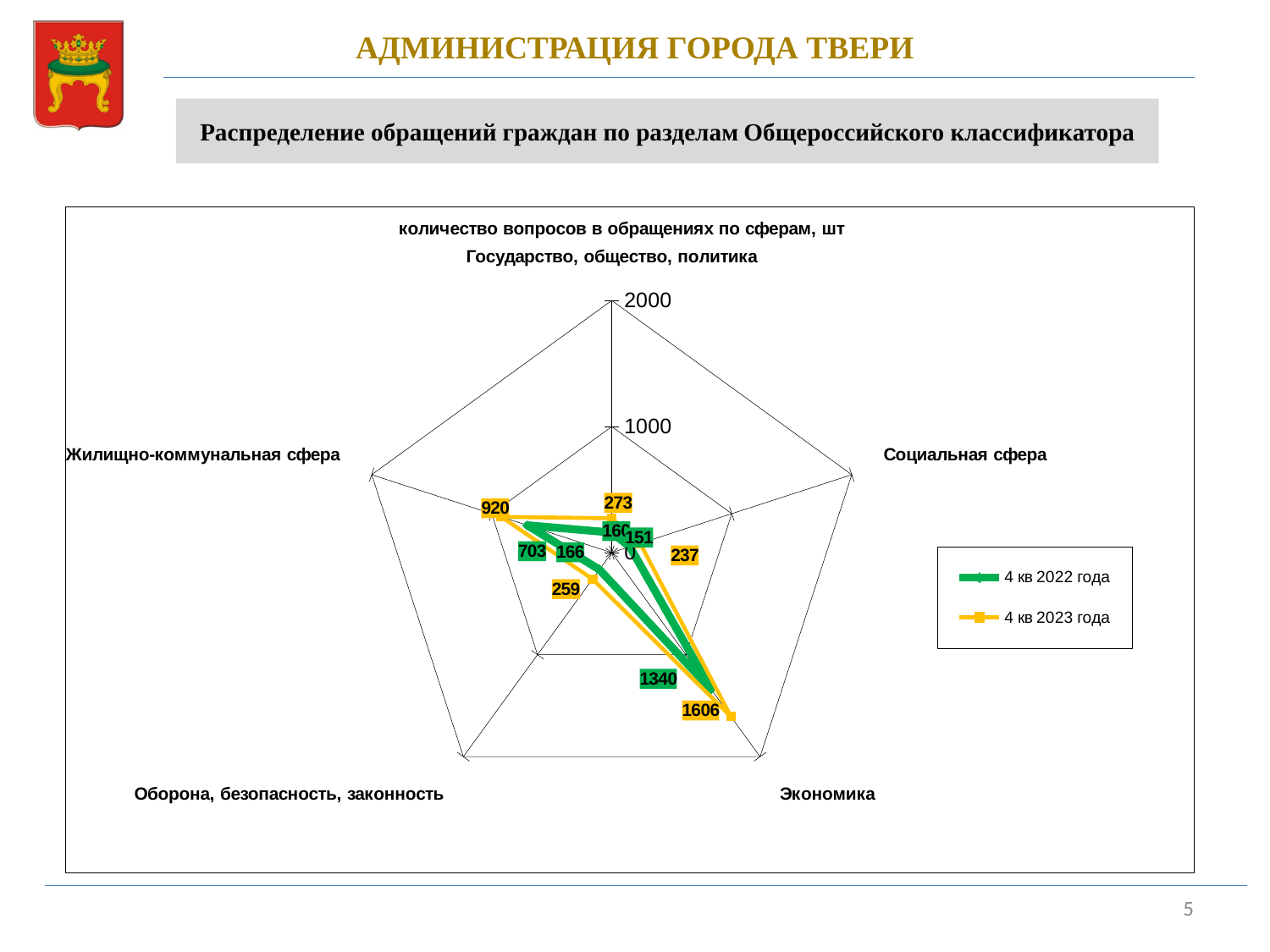
What is the difference between the 4 кв 2023 года and 4 кв 2022 года values for Экономика? 266 What is the value for Социальная сфера in 4 кв 2023 года? 237 What is the title of the chart? количество вопросов в обращениях по сферам, шт What is the value for Экономика in 4 кв 2022 года? 1340 How many categories (axes) does the radar chart have? 5 Which category has the highest value in 4 кв 2023 года? Экономика What is the value for Оборона, безопасность, законность in 4 кв 2023 года? 259 What kind of chart is shown on the slide? radar chart How many series does the legend list? 2 What is the value for Жилищно-коммунальная сфера in 4 кв 2022 года? 703 What is the value for Экономика in 4 кв 2023 года? 1606 What is the value for Жилищно-коммунальная сфера in 4 кв 2023 года? 920